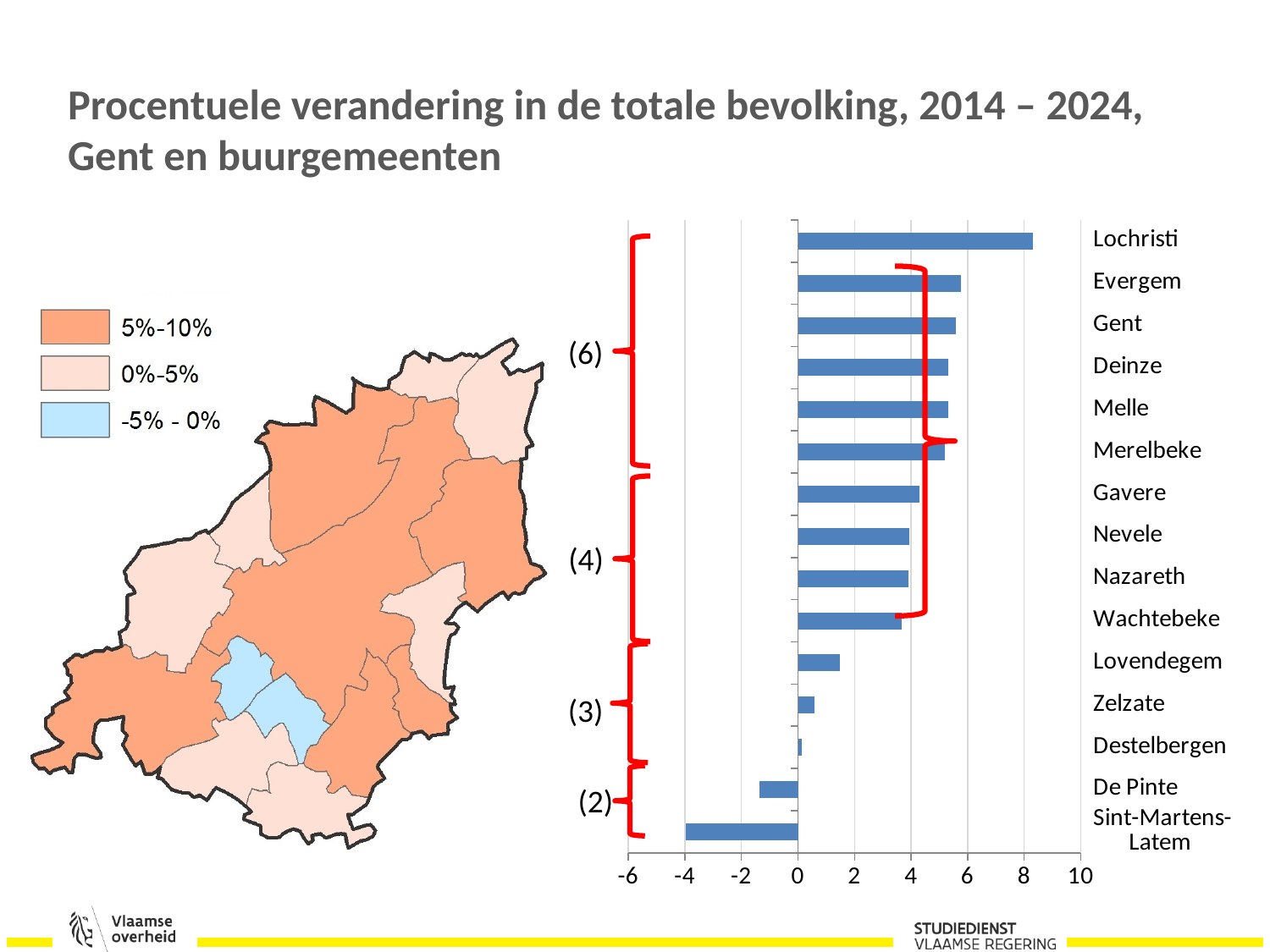
How many municipalities show a negative percentage change? 2 Is the value for Gavere greater or less than 4? greater Is the value for Sint-Martens-Latem greater or less than -2? less Which municipality has the lowest percentage change in total population? Sint-Martens-Latem What is the title of the slide? Procentuele verandering in de totale bevolking, 2014 – 2024, Gent en buurgemeenten What type of chart is shown on the slide? bar chart Is the value for Lovendegem greater or less than 2? less How many municipalities are shown in the bar chart? 15 Which municipality has the highest percentage change in total population? Lochristi Which has a larger percentage change, Lochristi or Gavere? Lochristi